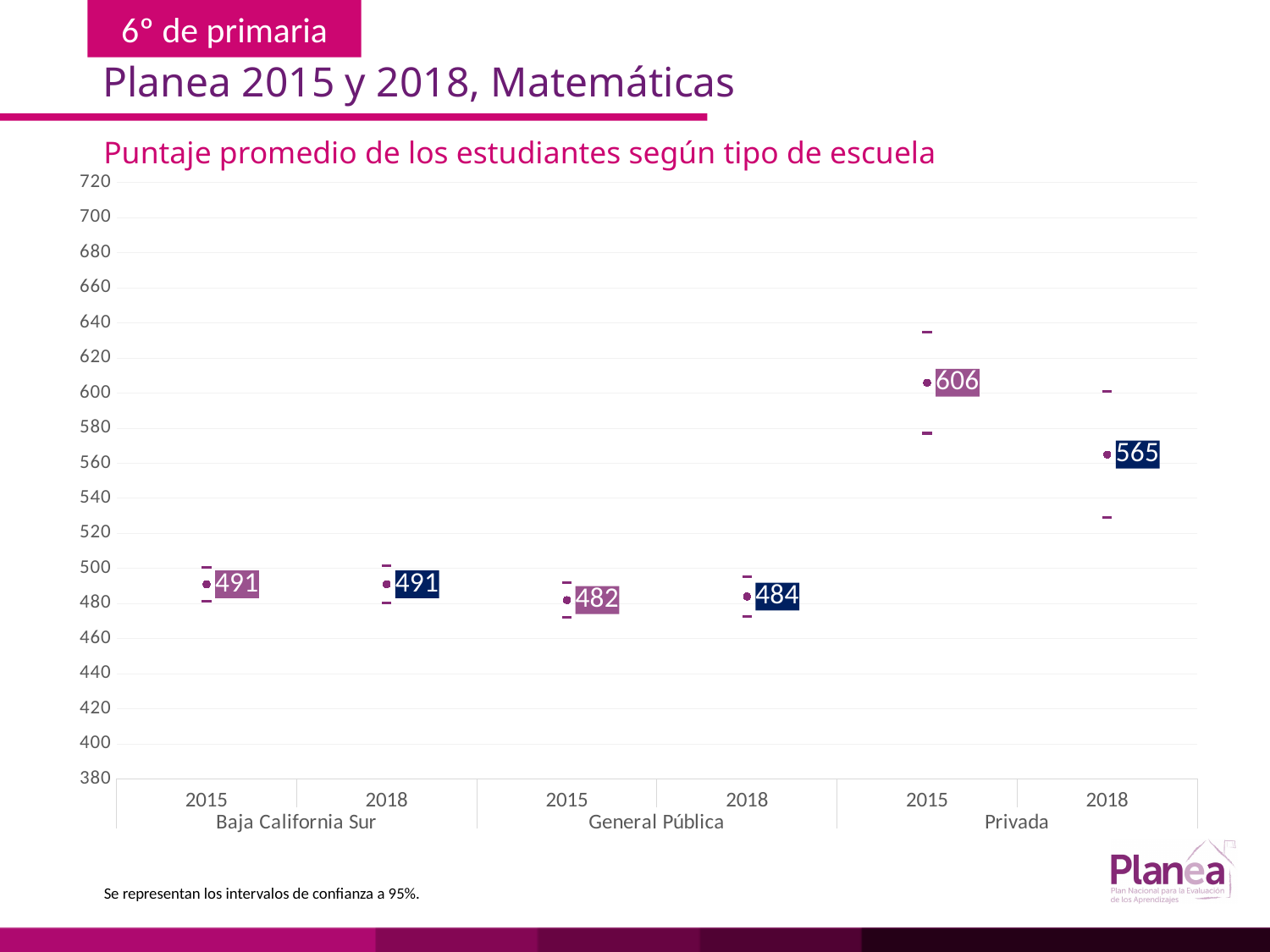
What is the title of the chart? Puntaje promedio de los estudiantes según tipo de escuela What is the average score for Baja California Sur in 2015? 491 Is the Privada score for 2018 greater or less than 600? less Which group and year has the lowest average score? General Pública, 2015 What is the difference between the General Pública scores in 2018 and 2015? 2 Which group and year has the highest average score? Privada, 2015 What is the difference between the Privada scores in 2015 and 2018? 41 What is the average score for Privada schools in 2015? 606 Which is larger, the Privada score in 2018 or the Baja California Sur score in 2018? Privada 2018 How many data points are plotted on the chart? 6 Did the Privada average score rise or fall from 2015 to 2018? fall What is the average score for General Pública schools in 2018? 484